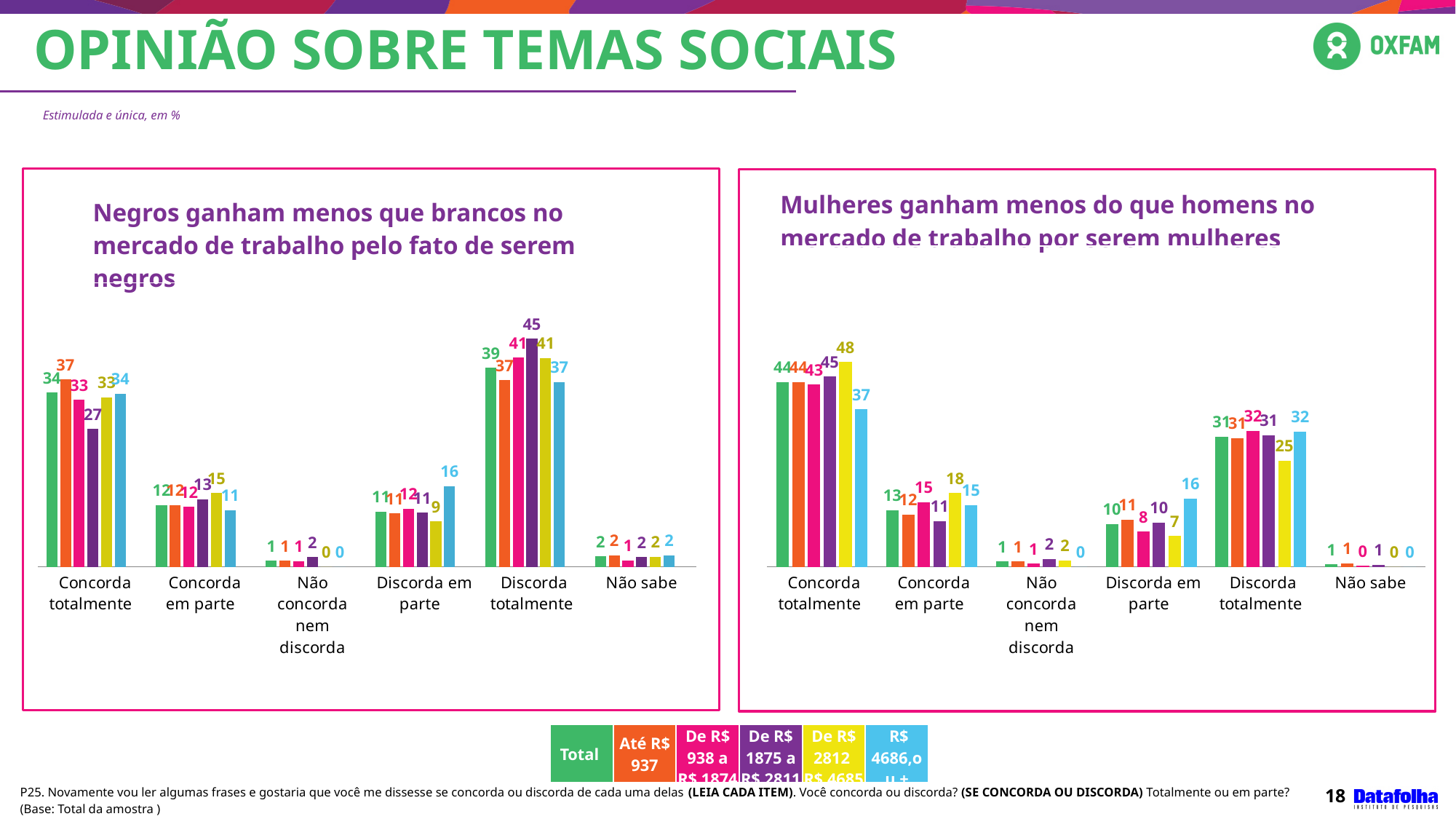
What kind of chart is the right chart (Mulheres ganham menos do que homens)? Bar chart How many series does the legend at the bottom of the slide list? 6 In the right chart (Mulheres ganham menos do que homens), what is the 'Até R$ 937' value for 'Discorda em parte'? 11 In the left chart (Negros ganham menos que brancos), which category has the lowest Total value? Não concorda nem discorda In the left chart (Negros ganham menos que brancos), what is the Total value for 'Discorda totalmente'? 39 In the right chart (Mulheres ganham menos do que homens), what is the Total value for 'Concorda totalmente'? 44 Which colour represents the 'Total' series in the legend? Green How many categories are shown on the x axis of the left chart (Negros ganham menos que brancos)? 6 In the right chart (Mulheres ganham menos do que homens), which category has the highest Total value? Concorda totalmente In the left chart (Negros ganham menos que brancos), what is the difference between the Total values for 'Discorda totalmente' and 'Concorda totalmente'? 5 In the right chart (Mulheres ganham menos do que homens), which is larger for the Total series: 'Concorda totalmente' or 'Discorda totalmente'? Concorda totalmente In the left chart (Negros ganham menos que brancos), what is the 'Até R$ 937' value for 'Concorda totalmente'? 37